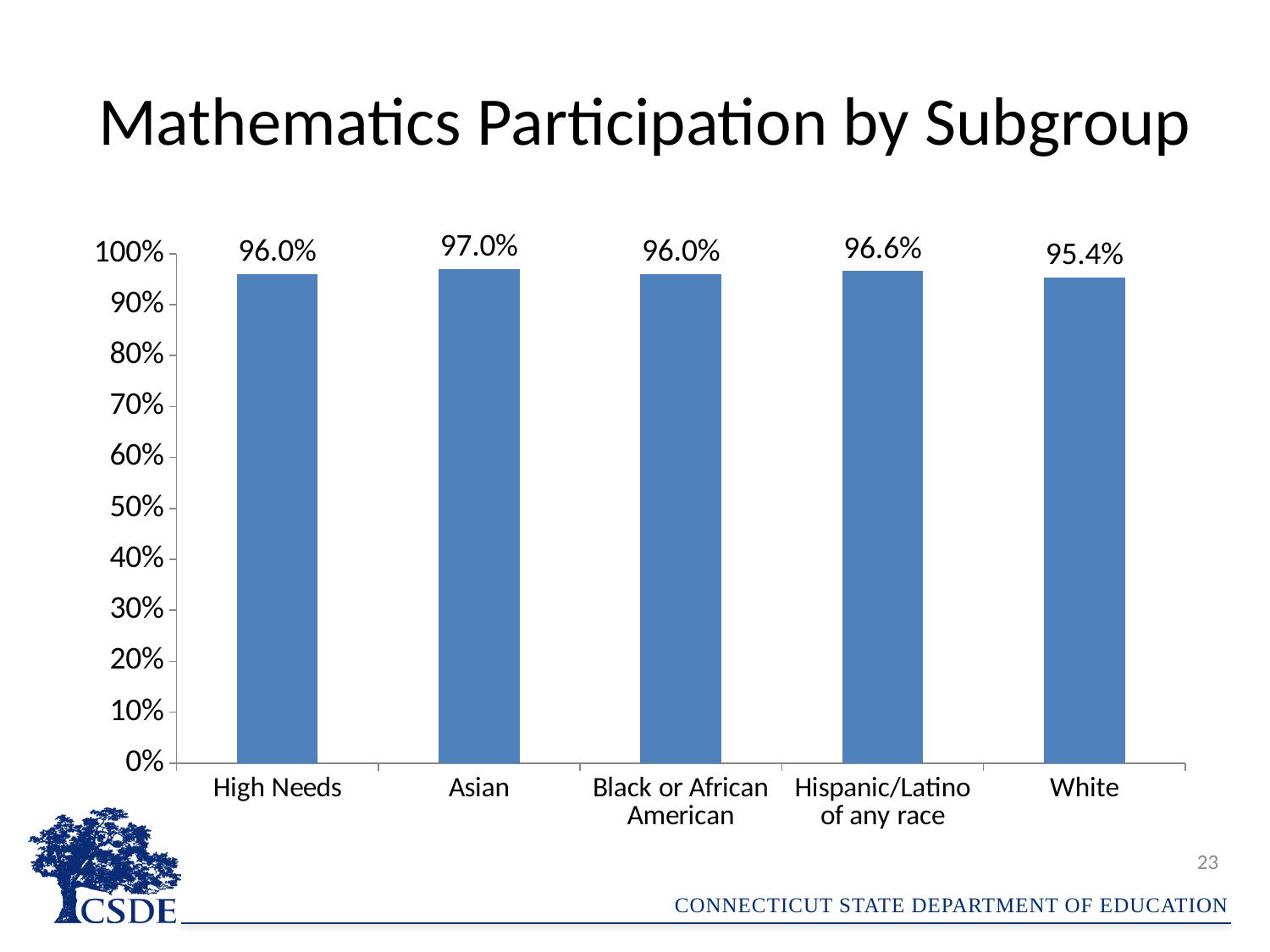
Which has a higher participation rate, Hispanic/Latino of any race or Black or African American? Hispanic/Latino of any race What is the mathematics participation rate for the Hispanic/Latino of any race subgroup? 96.6% Which subgroup has the highest mathematics participation rate? Asian What is the title of the slide containing the chart? Mathematics Participation by Subgroup How many subgroups are shown in the chart? 5 What is the difference in participation rate between the Asian and White subgroups? 1.6% What is the mathematics participation rate for the White subgroup? 95.4% What is the mathematics participation rate for the High Needs subgroup? 96.0% Which subgroup has the lowest mathematics participation rate? White What type of chart is used to show mathematics participation by subgroup? Bar chart What is the mathematics participation rate for the Asian subgroup? 97.0% Is the participation rate for the White subgroup greater or less than 90%? greater